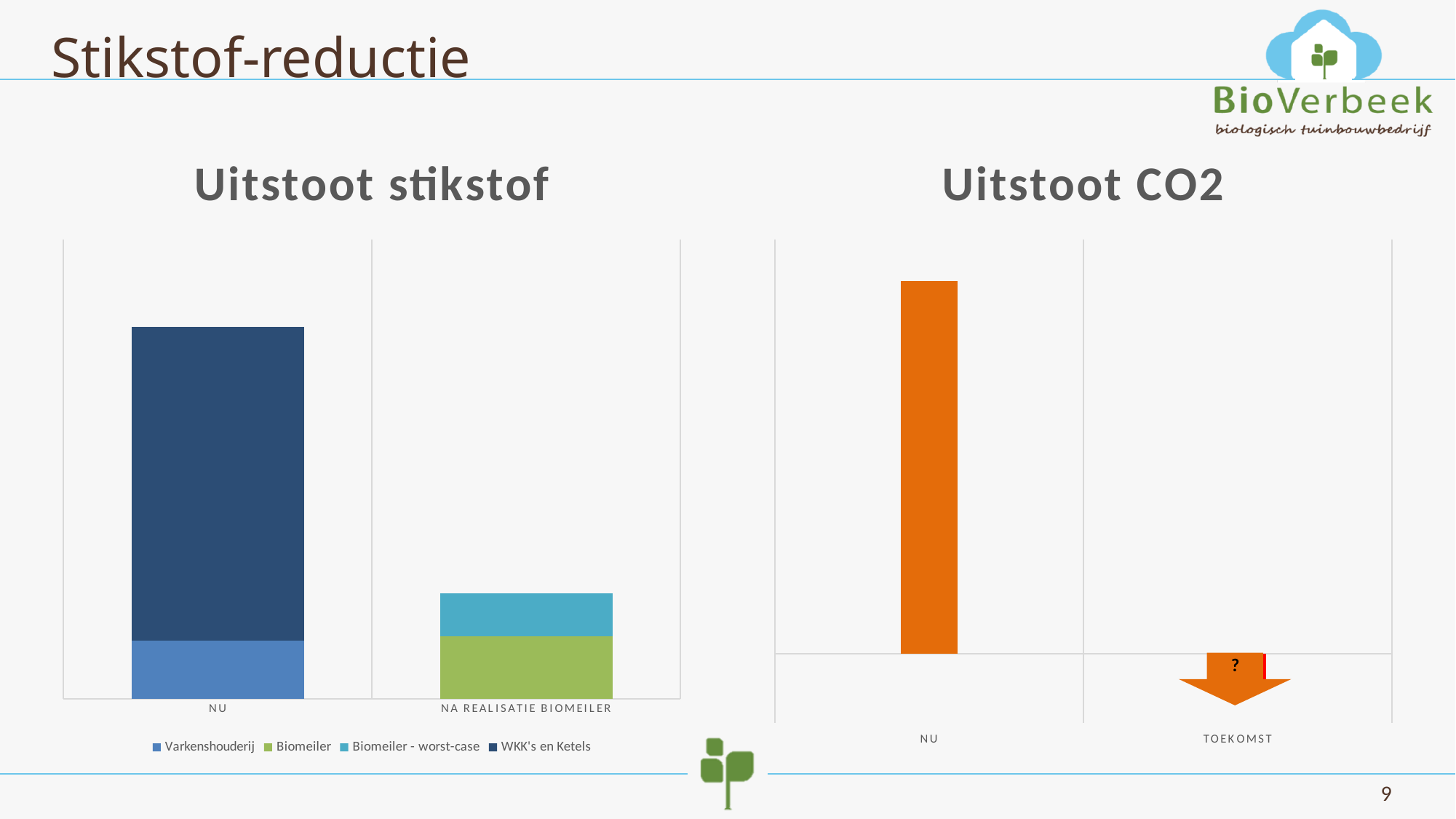
Do the stacked bar totals in the "Uitstoot stikstof" chart rise or fall from NU to NA REALISATIE BIOMEILER? fall What are the category labels on the x axis of the "Uitstoot CO2" chart? NU and TOEKOMST In the "Uitstoot stikstof" chart, which category has the lowest total emission? NA REALISATIE BIOMEILER In the "Uitstoot stikstof" chart, which category has the taller stacked bar, NU or NA REALISATIE BIOMEILER? NU How many categories are shown on the x axis of the "Uitstoot CO2" chart? 2 How many categories are shown on the x axis of the "Uitstoot stikstof" chart? 2 How many series does the legend of the "Uitstoot stikstof" chart list? 4 In the "Uitstoot stikstof" chart, which two series appear in the NA REALISATIE BIOMEILER bar? Biomeiler and Biomeiler - worst-case In the "Uitstoot stikstof" chart, which series makes up the largest part of the NU bar? WKK's en Ketels What kind of chart is the "Uitstoot stikstof" chart? bar chart In the "Uitstoot CO2" chart, which category has the highest bar? NU What kind of chart is the "Uitstoot CO2" chart? bar chart